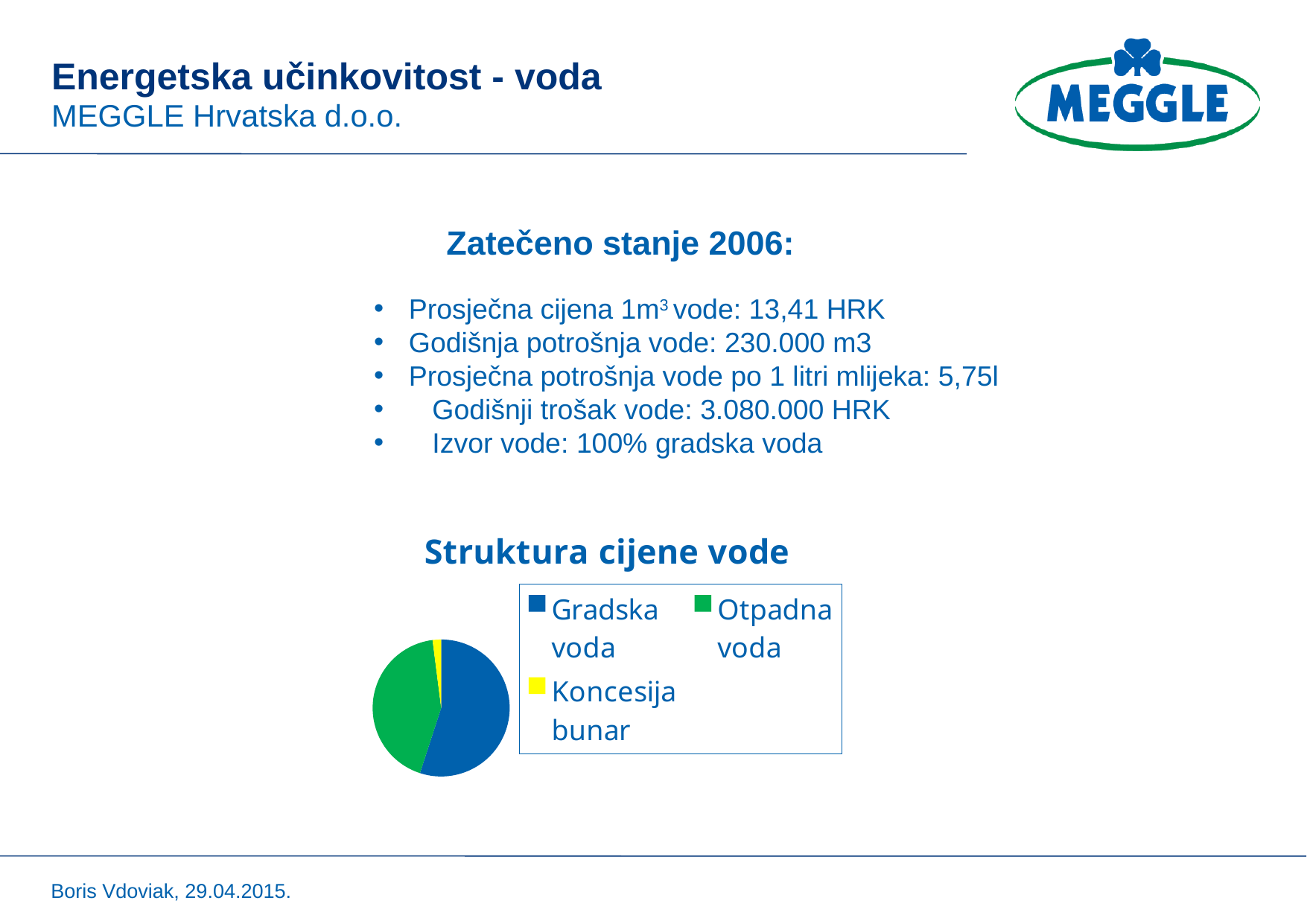
How many entries does the legend of the pie chart list? 3 What kind of chart is shown under the title "Struktura cijene vode"? pie chart Which category has the smallest slice in the pie chart? Koncesija bunar What is the title of the chart on the slide? Struktura cijene vode Which category has the largest slice in the pie chart? Gradska voda Which slice is larger in the pie chart, Otpadna voda or Koncesija bunar? Otpadna voda How many slices does the pie chart have? 3 Which slice is larger in the pie chart, Gradska voda or Otpadna voda? Gradska voda Which colour represents Koncesija bunar in the pie chart? yellow